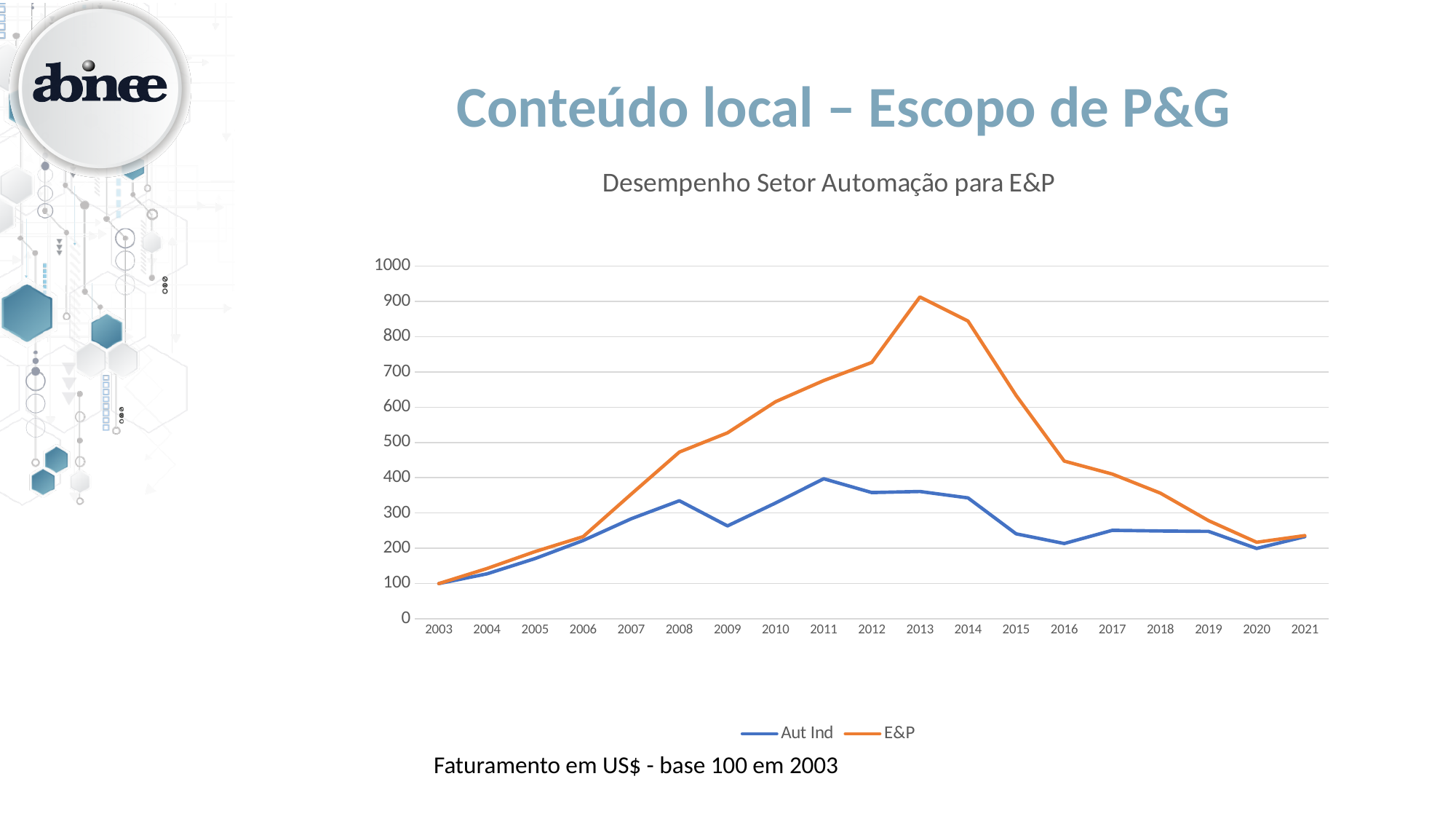
What kind of chart is shown on the slide? line chart Which series has the higher value in 2013, Aut Ind or E&P? E&P What is the title of the chart? Desempenho Setor Automação para E&P In which year is the Aut Ind series at its lowest value? 2003 In which year does the Aut Ind series reach its highest value? 2011 Is the value for E&P in 2013 greater or less than 800? greater How many series does the legend list? 2 In which year does the E&P series reach its highest value? 2013 How many years are plotted along the x axis? 19 Is the value for Aut Ind in 2011 greater or less than 500? less What is the value of the E&P series in 2003? 100 Does the E&P series rise or fall between 2013 and 2020? fall